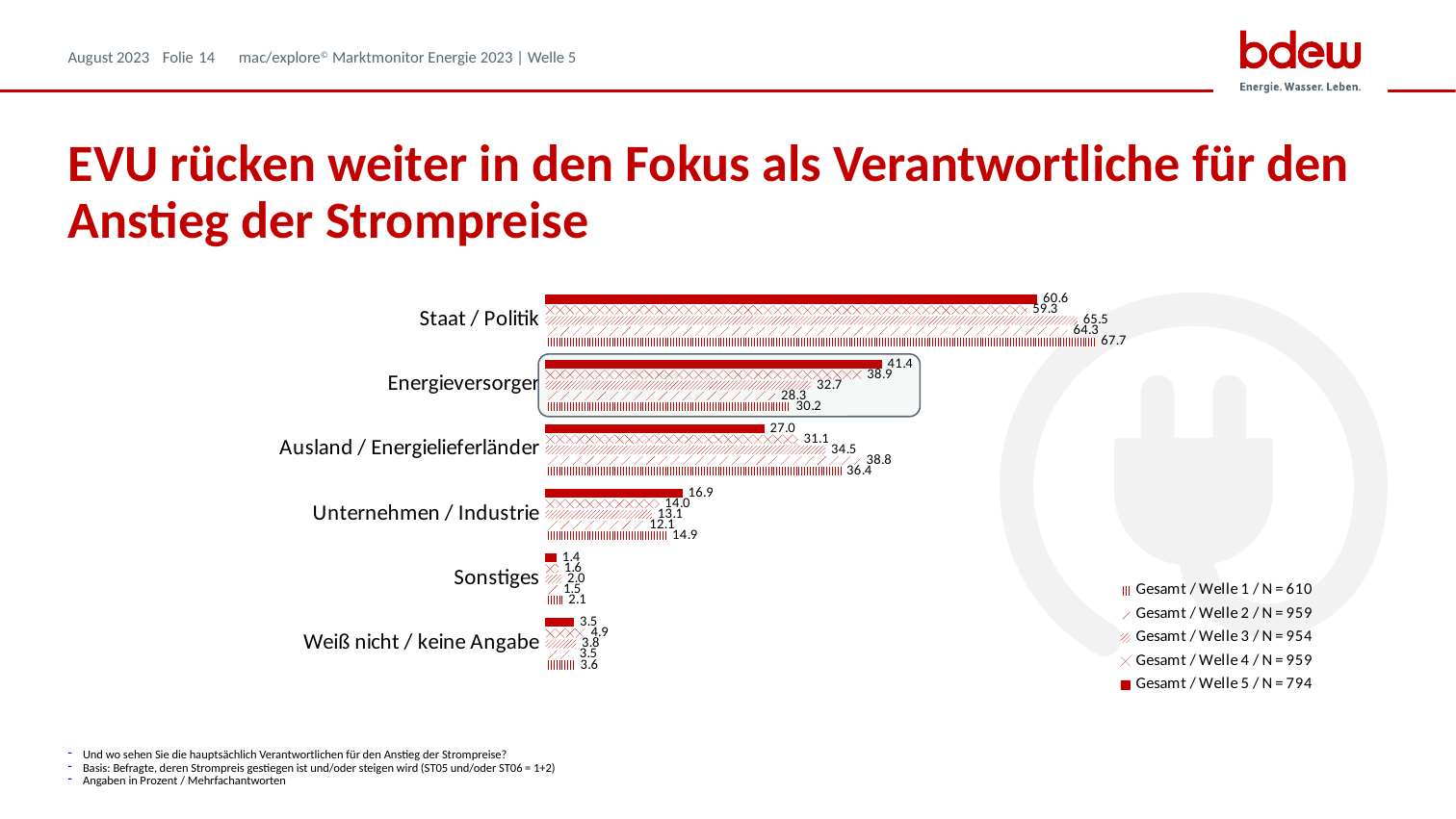
What is the value for Ausland / Energielieferländer in the Gesamt / Welle 2 series? 38.8 What is the value for Staat / Politik in the Gesamt / Welle 1 series? 67.7 How many series does the legend list? 5 Which category has the highest value in the Gesamt / Welle 5 series? Staat / Politik For Ausland / Energielieferländer, which is larger: the Gesamt / Welle 5 value or the Gesamt / Welle 3 value? Gesamt / Welle 3 What is the value for Energieversorger in the Gesamt / Welle 5 series? 41.4 What kind of chart is shown on the slide? Bar chart Which category has the lowest value in the Gesamt / Welle 5 series? Sonstiges For Energieversorger, do the values rise or fall from Welle 3 to Welle 5? Rise How many categories are shown on the chart? 6 What is the difference between the Gesamt / Welle 5 and Gesamt / Welle 1 values for Energieversorger? 11.2 What is the sample size (N) given in the legend for Gesamt / Welle 5? 794